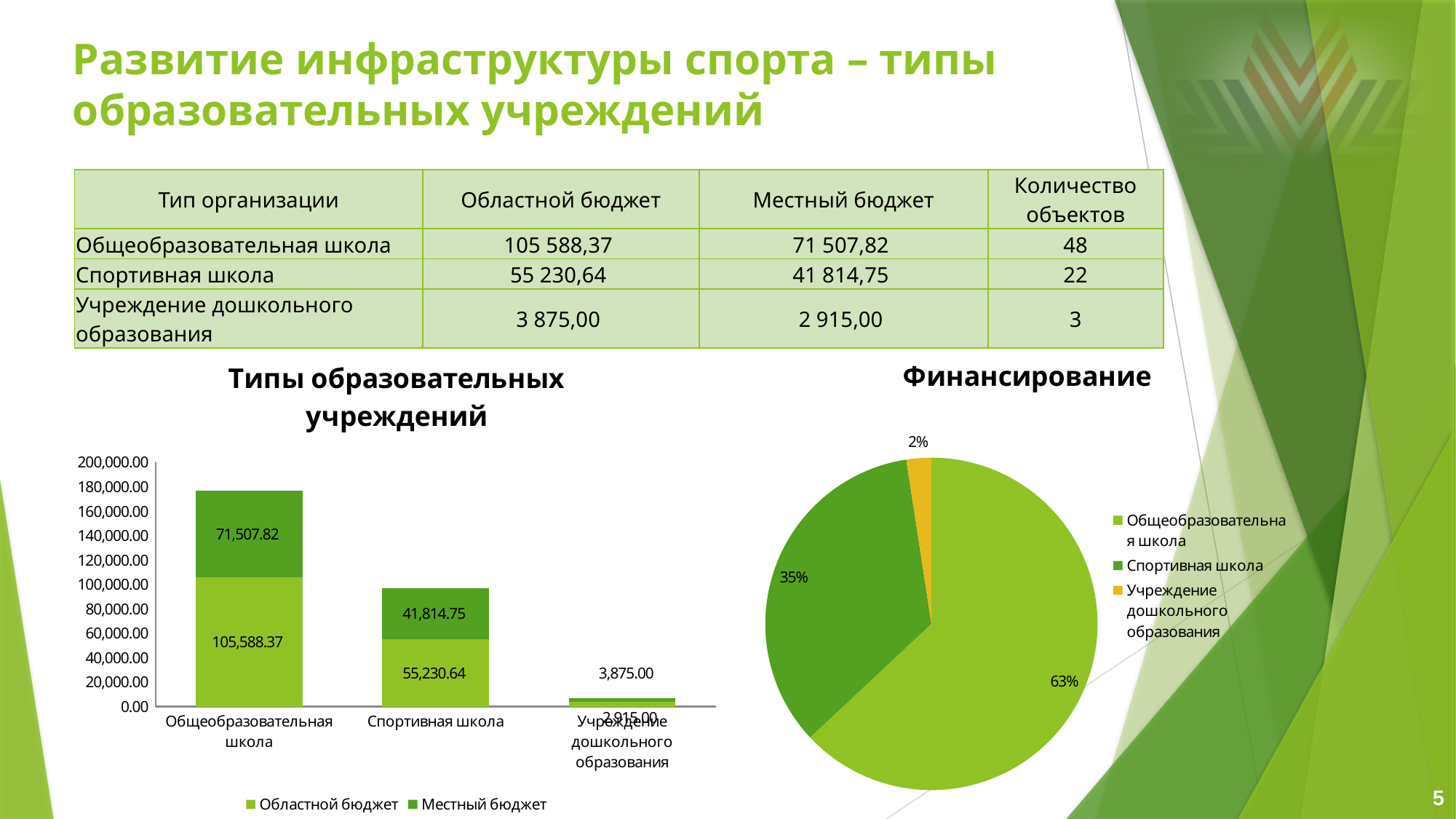
In the chart titled 'Типы образовательных учреждений', what is the value of 'Областной бюджет' for 'Общеобразовательная школа'? 105,588.37 In the chart titled 'Типы образовательных учреждений', what is the total of the stacked bar for 'Общеобразовательная школа'? 177,096.19 In the pie chart titled 'Финансирование', how many categories are shown? 3 What kind of chart is the chart titled 'Типы образовательных учреждений'? Stacked bar chart In the chart titled 'Типы образовательных учреждений', how many series does the legend list? 2 In the chart titled 'Типы образовательных учреждений', what is the total of the stacked bar for 'Спортивная школа'? 97,045.39 In the chart titled 'Типы образовательных учреждений', which category has the lowest total? Учреждение дошкольного образования In the chart titled 'Типы образовательных учреждений', what is the value of 'Областной бюджет' for 'Учреждение дошкольного образования'? 3,875.00 In the pie chart titled 'Финансирование', what share does 'Спортивная школа' have? 35% In the chart titled 'Типы образовательных учреждений', what is the value of 'Местный бюджет' for 'Спортивная школа'? 41,814.75 In the chart titled 'Типы образовательных учреждений', what is the difference between 'Областной бюджет' and 'Местный бюджет' for 'Общеобразовательная школа'? 34,080.55 In the pie chart titled 'Финансирование', which category has the largest slice? Общеобразовательная школа